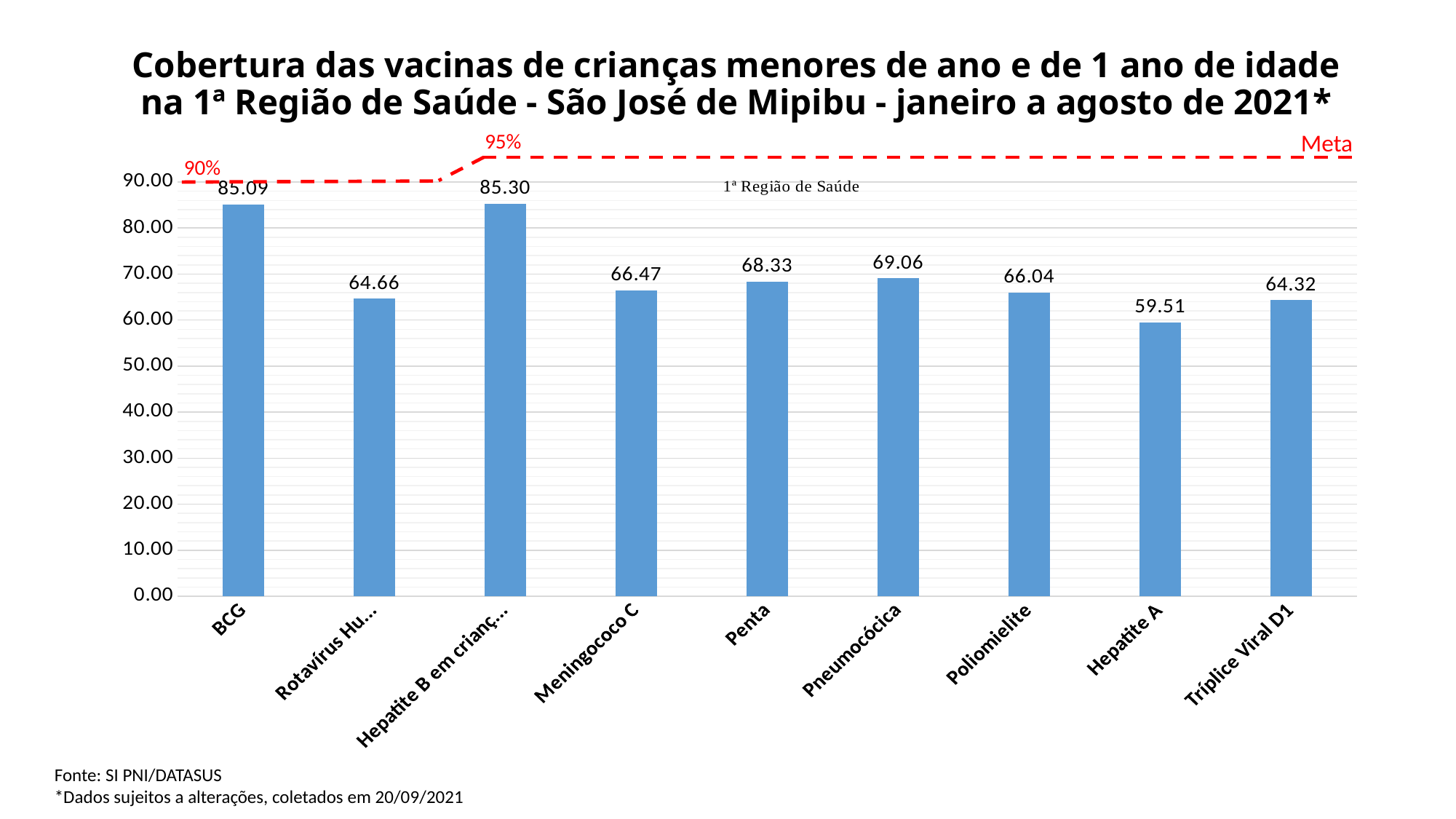
Is the value for Hepatite A greater or less than 60.00? less What is the coverage value for Poliomielite? 66.04 What is the coverage value for Penta? 68.33 What is the coverage value for Pneumocócica? 69.06 What is the difference between the values for Pneumocócica and Poliomielite? 3.02 Which is larger, the value for Meningococo C or the value for Tríplice Viral D1? Meningococo C What is the coverage value for BCG? 85.09 What kind of chart is shown on the slide? bar chart What is the coverage value for Hepatite A? 59.51 Which vaccine has the lowest coverage value? Hepatite A What is the difference between the values for BCG and Hepatite A? 25.58 How many vaccine categories are shown on the x axis? 9